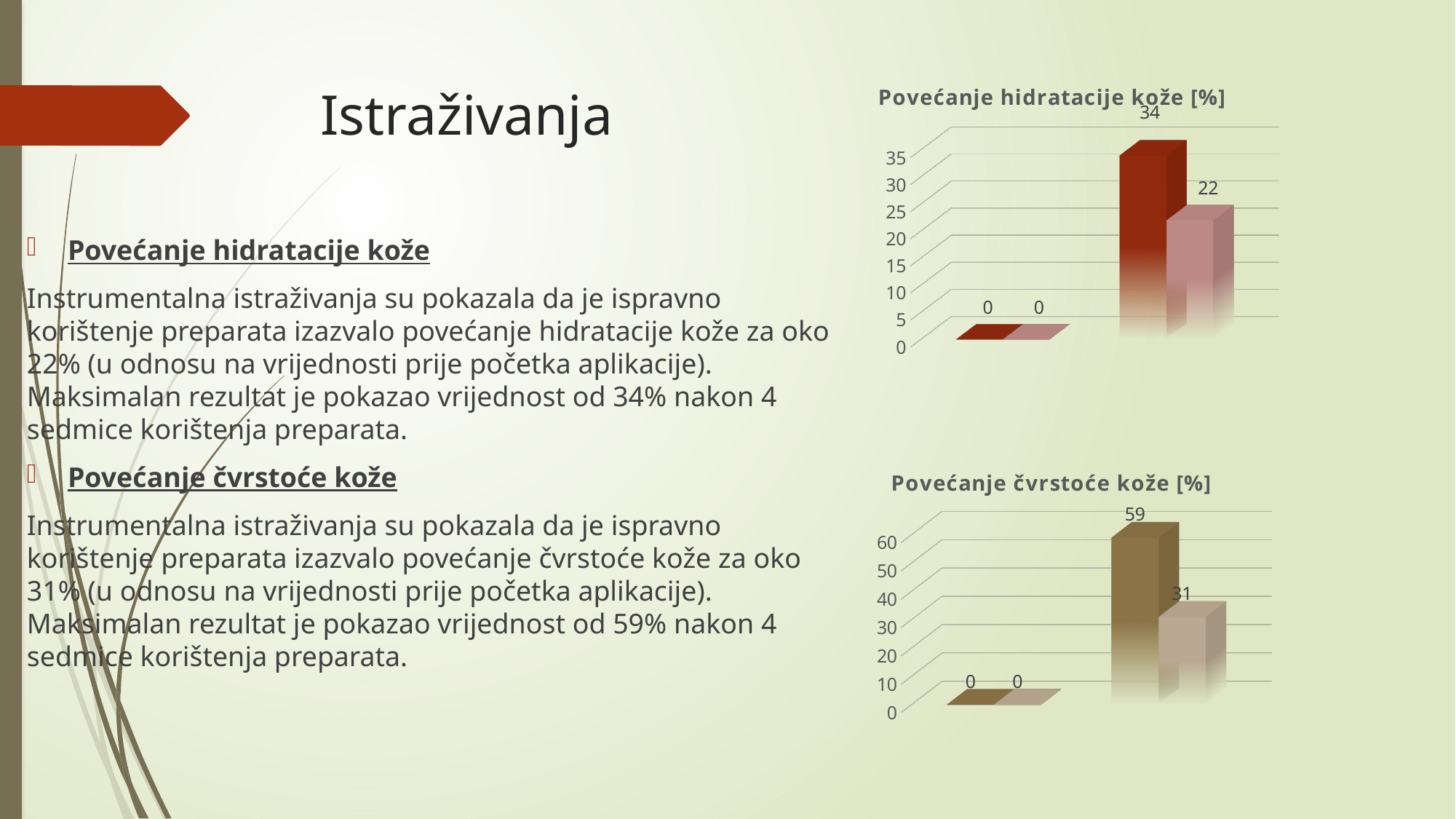
How many bars are plotted in the 'Povećanje hidratacije kože [%]' chart? 4 In the 'Povećanje čvrstoće kože [%]' chart, what is the difference between the two non-zero data labels, 59 and 31? 28 How many bars are plotted in the 'Povećanje čvrstoće kože [%]' chart? 4 In the 'Povećanje čvrstoće kože [%]' chart, is the shorter non-zero bar greater or less than 40? less In the 'Povećanje hidratacije kože [%]' chart, what is the difference between the two non-zero data labels, 34 and 22? 12 In the 'Povećanje hidratacije kože [%]' chart, what is the highest value shown by a data label? 34 What type of chart is the 'Povećanje hidratacije kože [%]' chart? bar chart In the 'Povećanje čvrstoće kože [%]' chart, what is the highest value shown by a data label? 59 In the 'Povećanje hidratacije kože [%]' chart, is the tallest bar greater or less than 30? greater Which chart has the larger maximum value, 'Povećanje hidratacije kože [%]' or 'Povećanje čvrstoće kože [%]'? Povećanje čvrstoće kože [%] What is the title of the upper chart on the slide? Povećanje hidratacije kože [%] What type of chart is the 'Povećanje čvrstoće kože [%]' chart? bar chart